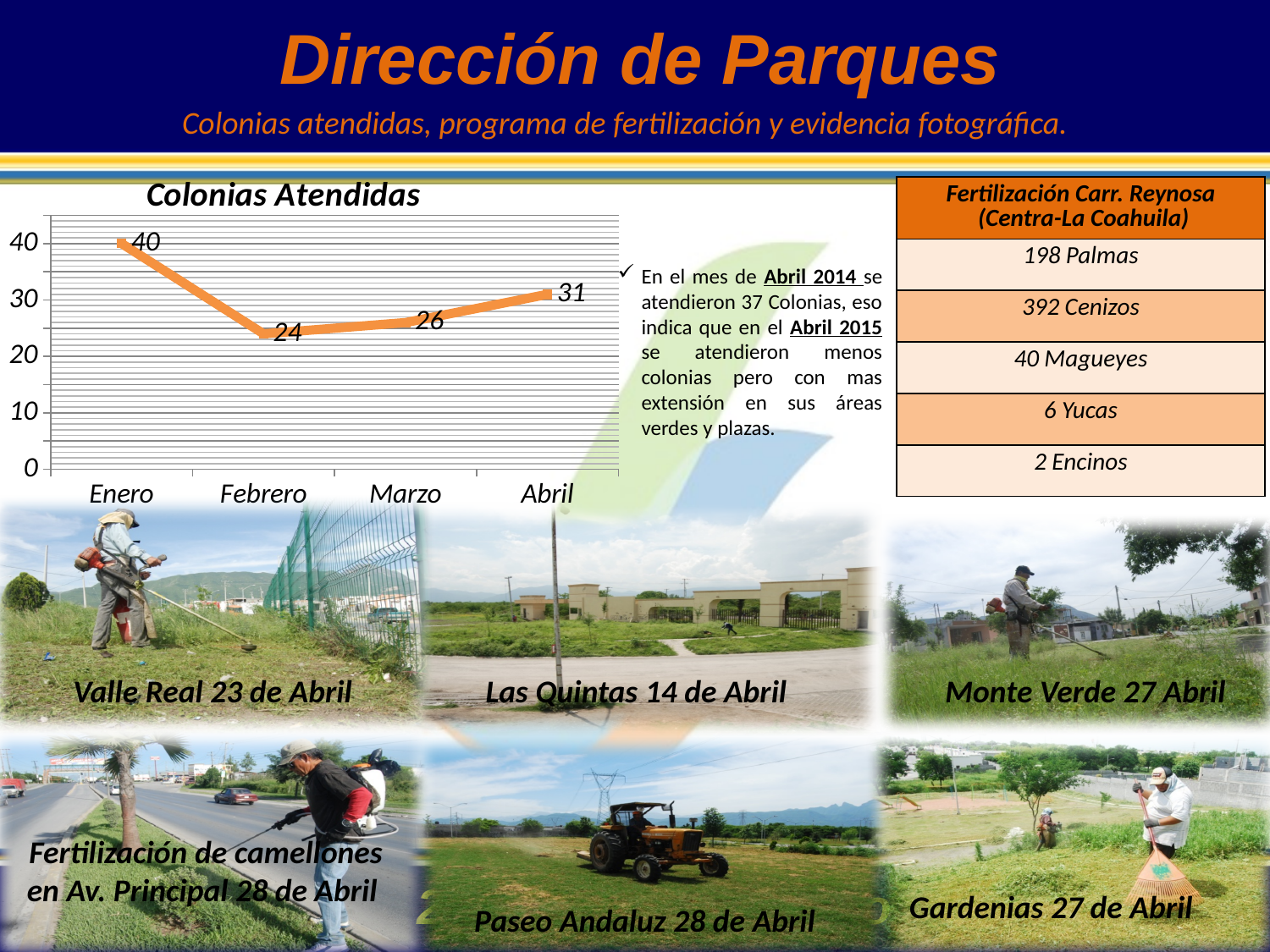
What is the value for Abril in the Colonias Atendidas chart? 31 What is the value for Enero in the Colonias Atendidas chart? 40 Which is larger in the Colonias Atendidas chart, the value for Marzo or the value for Abril? Abril What is the difference between the values for Abril and Marzo in the Colonias Atendidas chart? 5 What is the value for Marzo in the Colonias Atendidas chart? 26 What is the difference between the values for Enero and Febrero in the Colonias Atendidas chart? 16 What kind of chart is the Colonias Atendidas chart? Line chart Which month has the lowest value in the Colonias Atendidas chart? Febrero What is the value for Febrero in the Colonias Atendidas chart? 24 How many months are plotted in the Colonias Atendidas chart? 4 Which month has the highest value in the Colonias Atendidas chart? Enero Do the values in the Colonias Atendidas chart rise or fall from Febrero to Abril? Rise